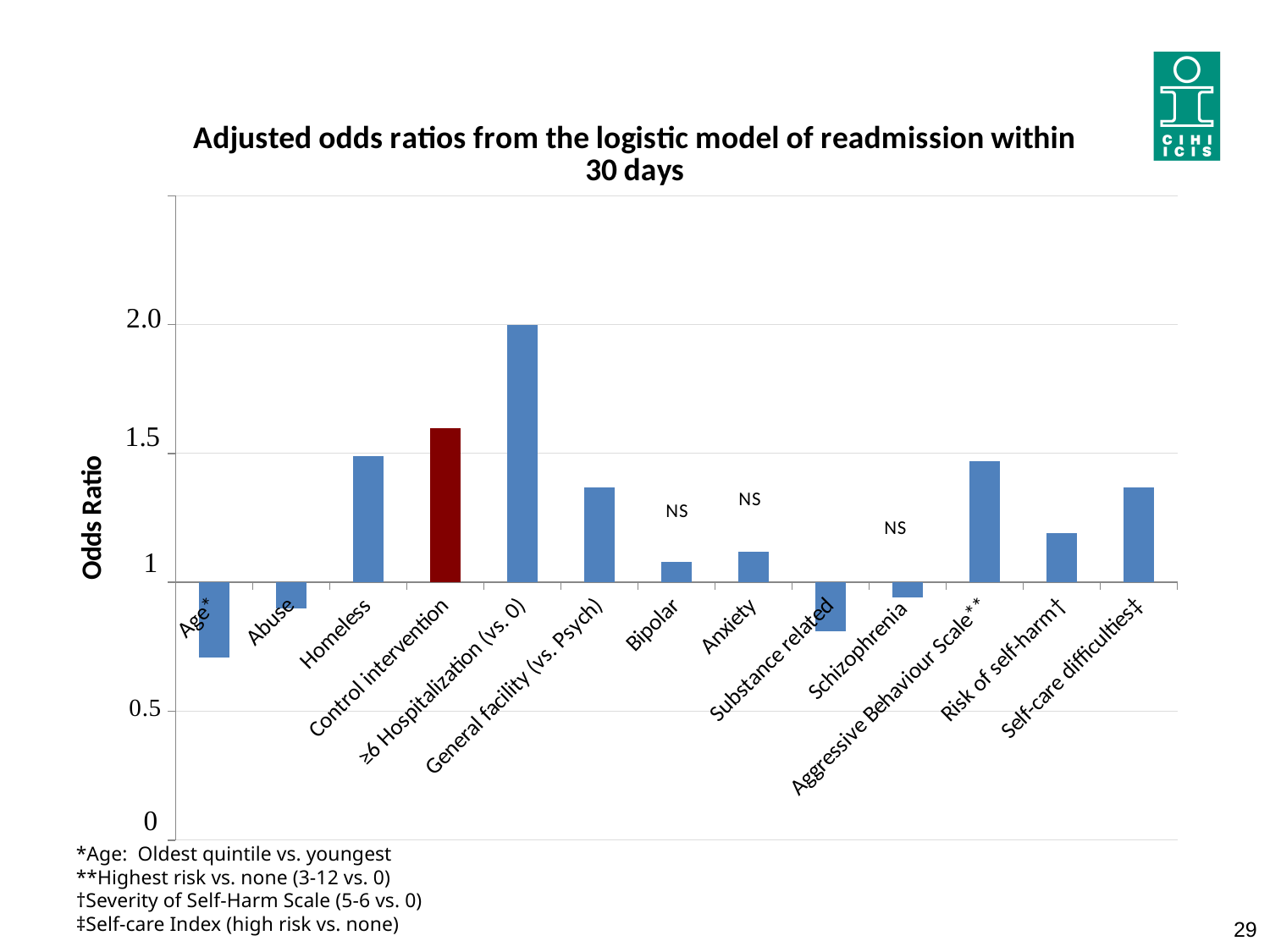
Is the odds ratio for Age* greater or less than 1? less Is the odds ratio for Homeless greater or less than 1? greater Which has the larger odds ratio, Homeless or Bipolar? Homeless Is the odds ratio for Substance related greater or less than 1? less How many categories are plotted on the x axis? 13 Which has the larger odds ratio, Aggressive Behaviour Scale** or Risk of self-harm†? Aggressive Behaviour Scale** Which category has the lowest odds ratio? Age* What is the title of the y axis? Odds Ratio Which category's bar is coloured red rather than blue? Control intervention Which category has the highest odds ratio? ≥6 Hospitalization (vs. 0) What kind of chart is shown on the slide? bar chart